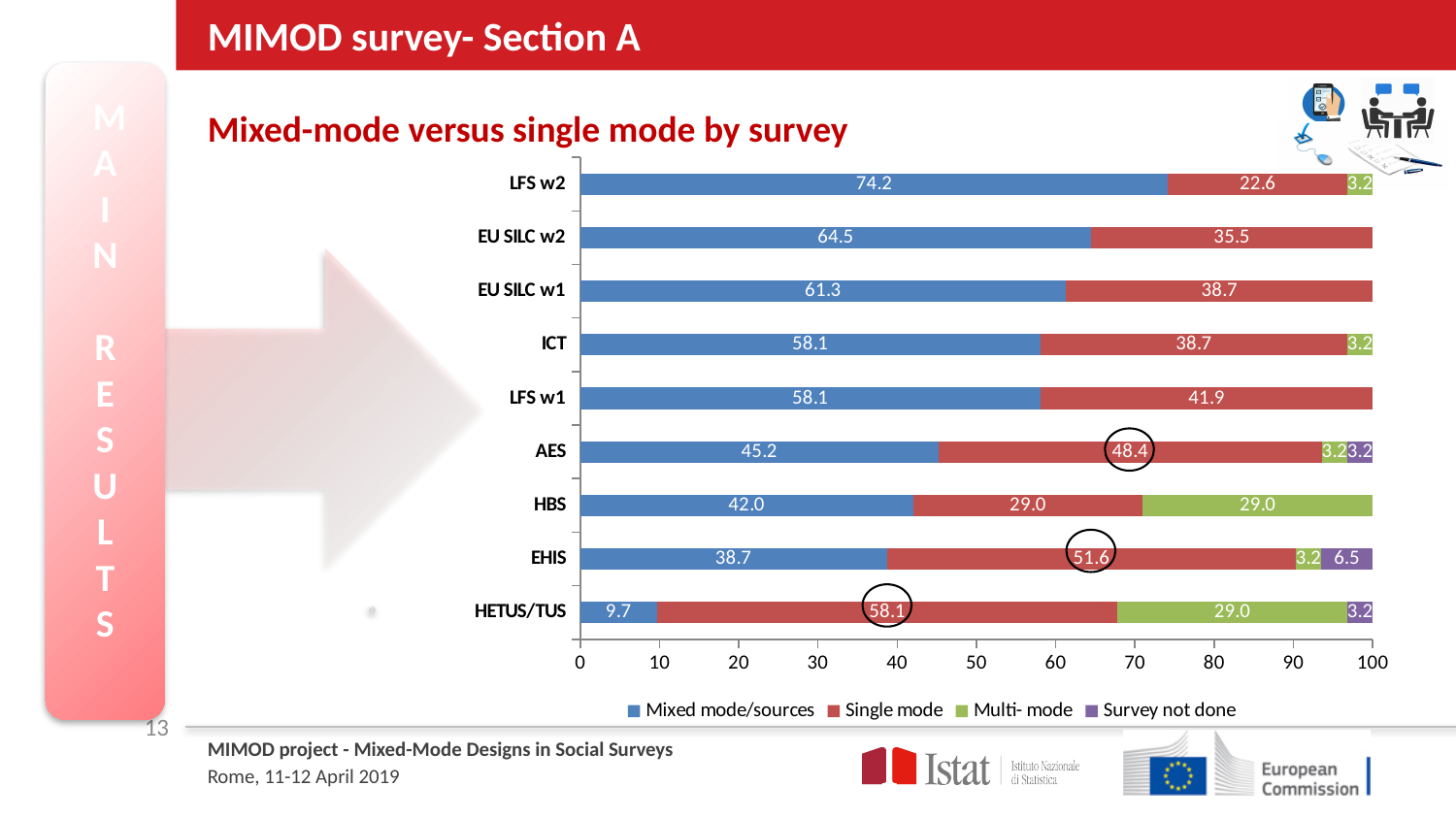
What is the Survey not done value for EHIS? 6.5 What kind of chart is shown on the slide? Stacked bar chart How many series does the legend list? 4 Which survey has the highest Mixed mode/sources value? LFS w2 Which is larger: the Single mode value for AES or the Single mode value for LFS w1? AES What is the difference between the Mixed mode/sources values for EU SILC w2 and EU SILC w1? 3.2 Which survey has the lowest Mixed mode/sources value? HETUS/TUS What is the Multi-mode value for HBS? 29.0 What is the Single mode value for EHIS? 51.6 What is the total of the Mixed mode/sources and Single mode segments for HETUS/TUS? 67.8 How many surveys (categories) are plotted on the chart? 9 What is the Mixed mode/sources value for LFS w2? 74.2